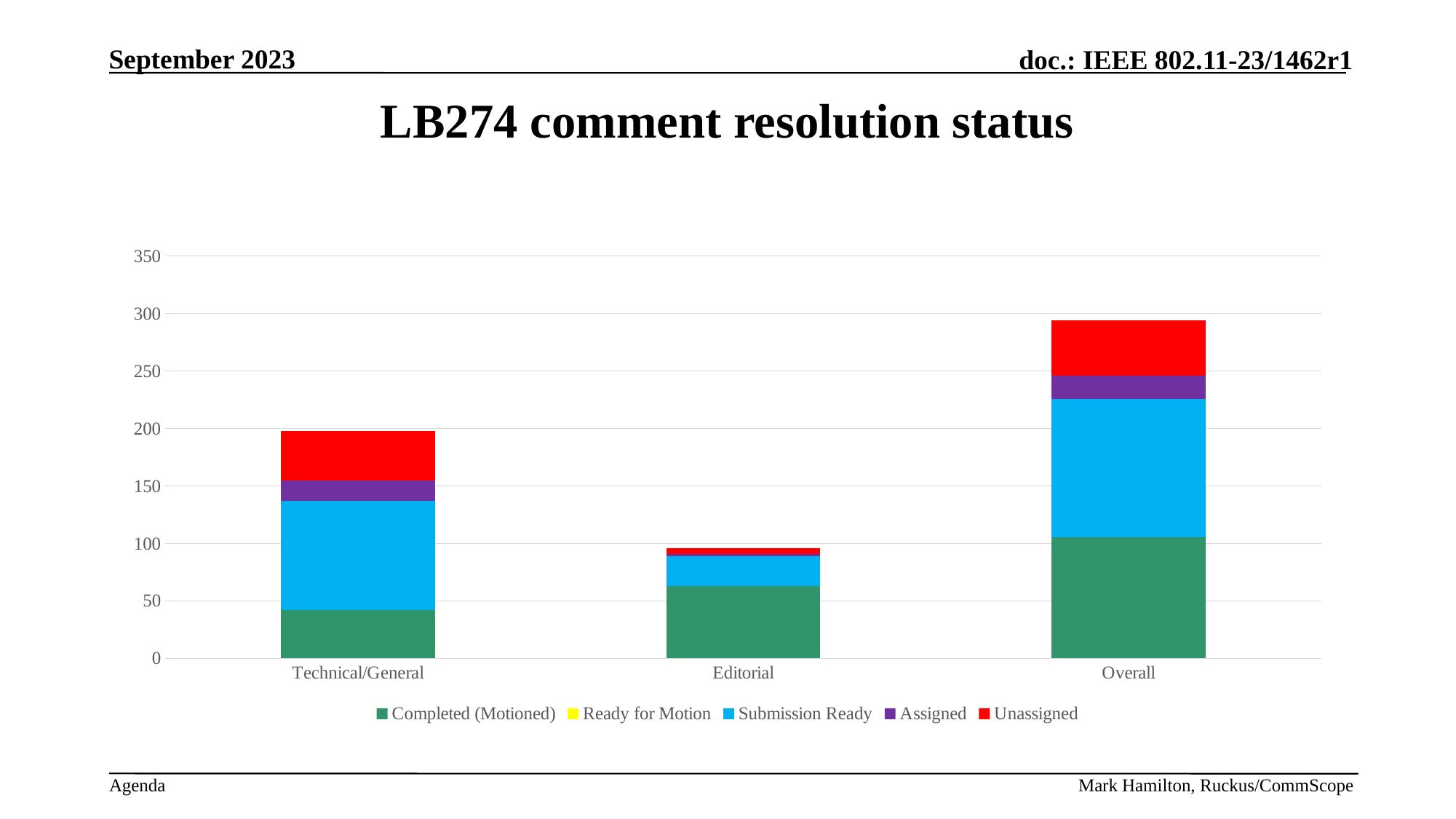
Is the total height of the Technical/General bar greater or less than 150? greater Which colour represents the Unassigned series in the legend? red Is the Completed (Motioned) segment for Technical/General greater or less than 50? less How many series does the legend list? 5 Which category has the tallest stacked bar overall? Overall Which has the larger Completed (Motioned) segment, Technical/General or Editorial? Editorial What is the title of the chart? LB274 comment resolution status What kind of chart is shown on the slide? stacked bar chart Which category has the shortest stacked bar overall? Editorial How many categories are shown on the x axis? 3 Is the total height of the Overall bar greater or less than 250? greater